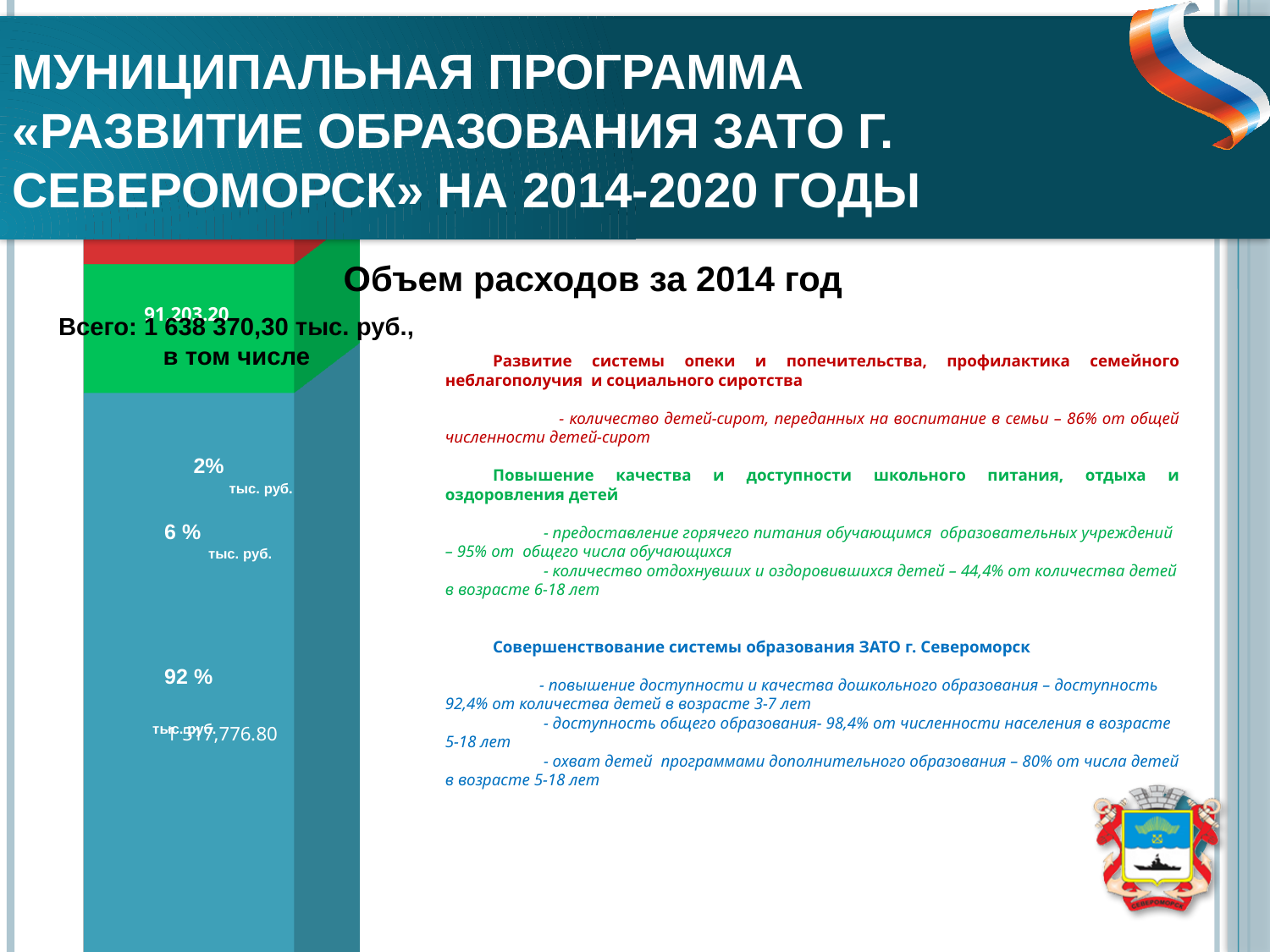
What is the title of the chart section on the slide? Объем расходов за 2014 год What value in тыс. руб. is printed for the 92 % segment of the bar? 1 517,776.80 What is the difference in percentage points between the 92 % segment and the 6 % segment? 86 What percentage is shown for the green segment of the bar? 6 % What kind of chart is shown on the left of the slide? bar chart What value in тыс. руб. is printed for the green segment of the bar? 91,203.20 What total amount of expenditure is stated above the chart? 1 638 370,30 тыс. руб. What colour is the segment representing 92 % of the bar? blue What percentage is shown for the smallest (red, top) segment of the bar? 2% What percentage is shown for the largest (blue) segment of the bar? 92 % How many segments make up the stacked bar on the slide? 3 Which segment is larger, the one labelled 6 % or the one labelled 2%? 6 %